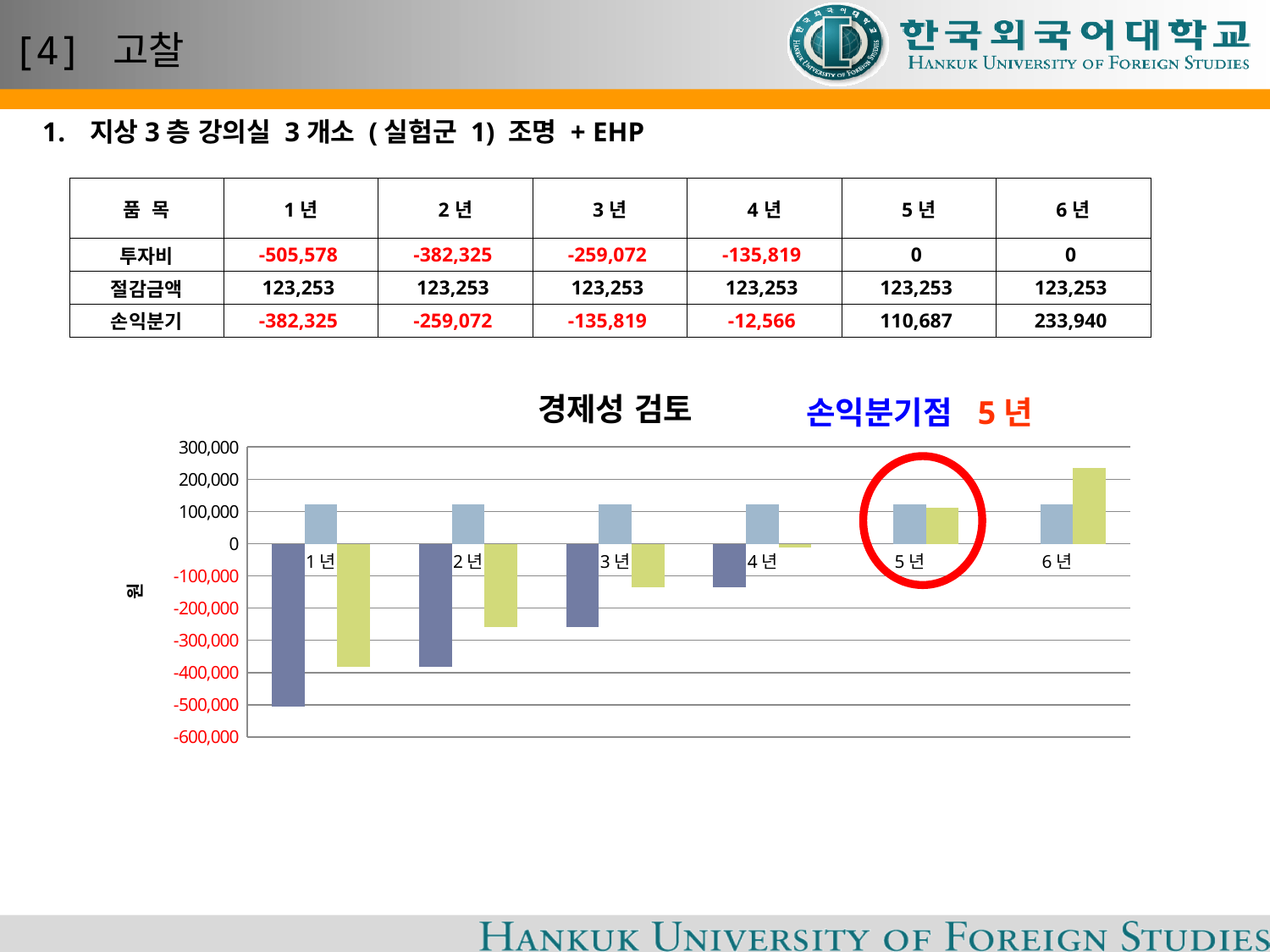
What kind of chart is shown on the slide? bar chart What is the difference between the 손익분기 values for 6 년 and 5 년? 123,253 According to the table, what is the 투자비 value for 1 년? -505,578 What is the title of the chart? 경제성 검토 Which year category on the chart is circled in red? 5 년 According to the table, what is the 손익분기 value for 6 년? 233,940 Do the 손익분기 values rise or fall from 1 년 to 6 년? rise In which year is the 투자비 value the lowest? 1 년 How many year categories are shown on the x axis of the chart? 6 According to the table, what is the 절감금액 value for 3 년? 123,253 In which year is the 손익분기 value the highest? 6 년 Is the 손익분기 bar for 6 년 greater or less than 200,000? greater